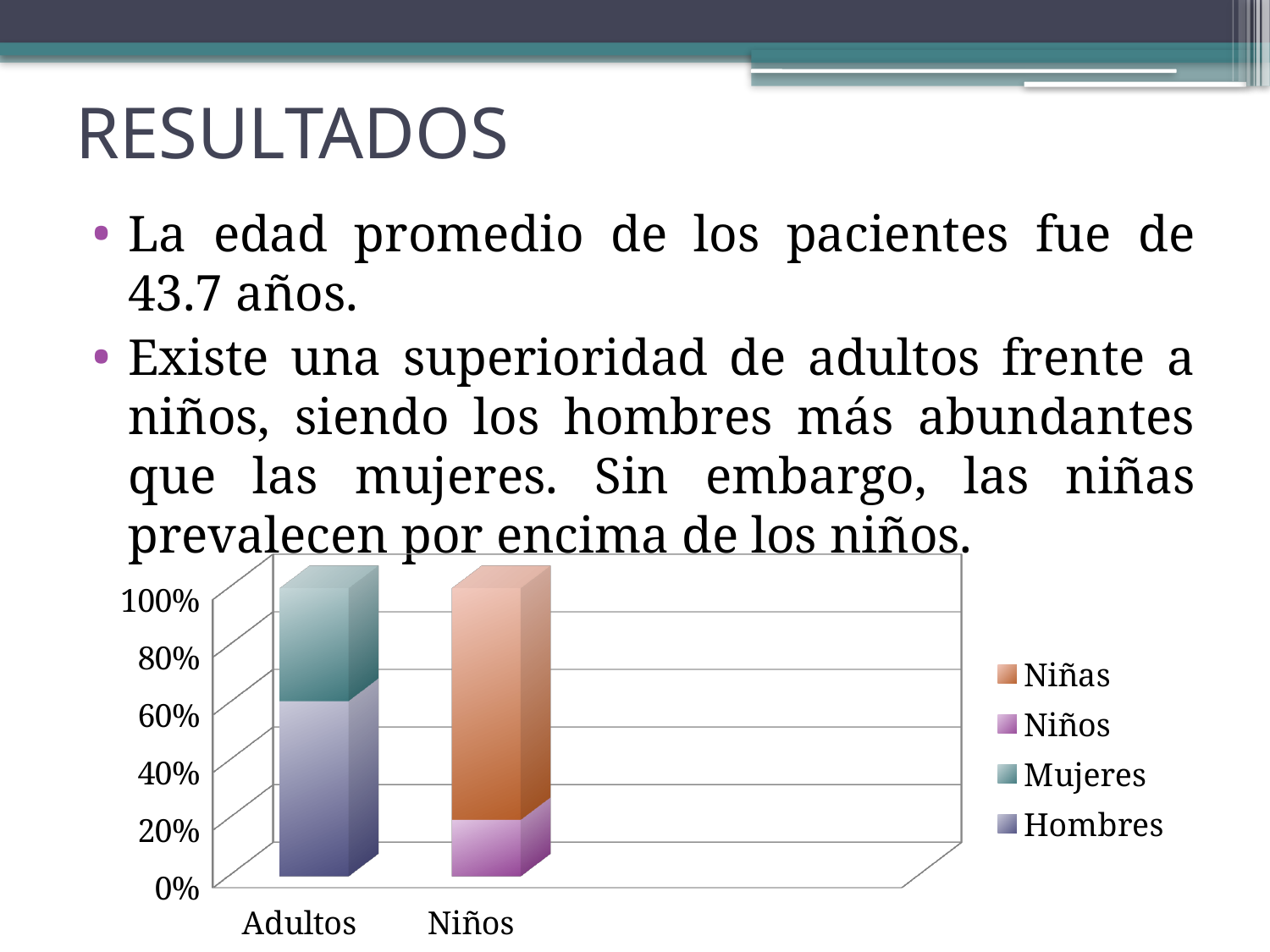
Is the Hombres share of the Adultos bar greater or less than 40%? greater Is the Niños share of the Niños bar greater or less than 40%? less How many categories are shown on the x axis of the chart? 2 What is the total height of the Adultos stacked bar? 100% Is the Hombres share of the Adultos bar greater or less than 80%? less Which series are listed in the chart legend? Niñas, Niños, Mujeres, Hombres What are the two categories on the x axis of the chart? Adultos and Niños How many series does the chart legend list? 4 In the Adultos bar, which segment is larger, Hombres or Mujeres? Hombres In the Niños bar, which segment is larger, Niñas or Niños? Niñas What kind of chart is shown on the slide? Stacked bar chart